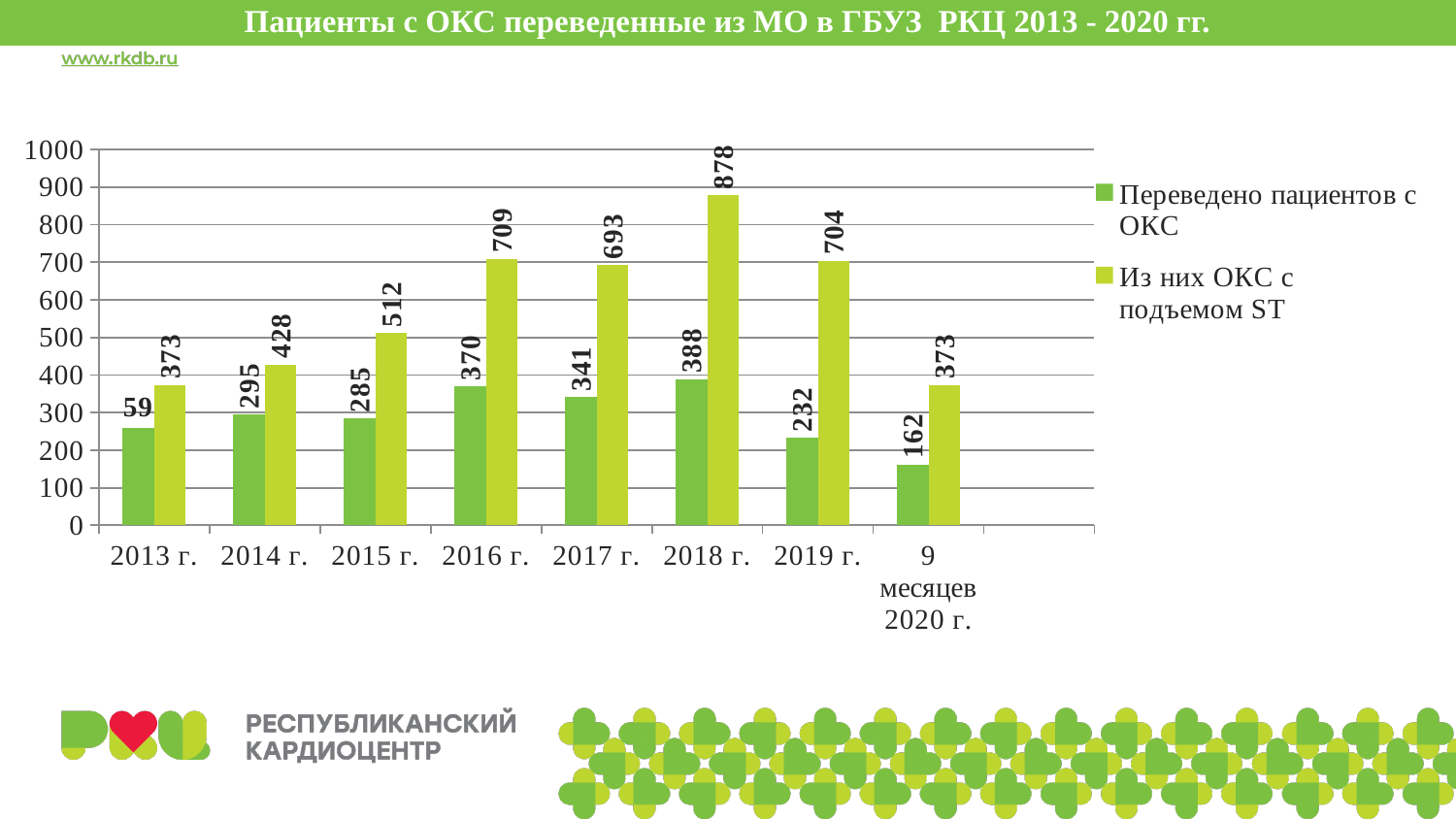
In which year is the 'Из них ОКС с подъемом ST' series highest? 2018 г. What kind of chart is shown on the slide? bar chart Is the 'Переведено пациентов с ОКС' value for 2019 г. greater or less than 300? less What is the difference between the two series' values for 2018 г.? 490 What is the value of the 'Из них ОКС с подъемом ST' series for 9 месяцев 2020 г.? 373 What is the value of the 'Переведено пациентов с ОКС' series for 2016 г.? 370 What is the value of the 'Из них ОКС с подъемом ST' series for 2018 г.? 878 Which year has the larger 'Из них ОКС с подъемом ST' value, 2016 г. or 2017 г.? 2016 г. What is the difference between the 'Из них ОКС с подъемом ST' values for 2019 г. and 9 месяцев 2020 г.? 331 How many categories are shown on the x axis? 8 How many series does the legend list? 2 In which year is the 'Переведено пациентов с ОКС' series highest? 2018 г.